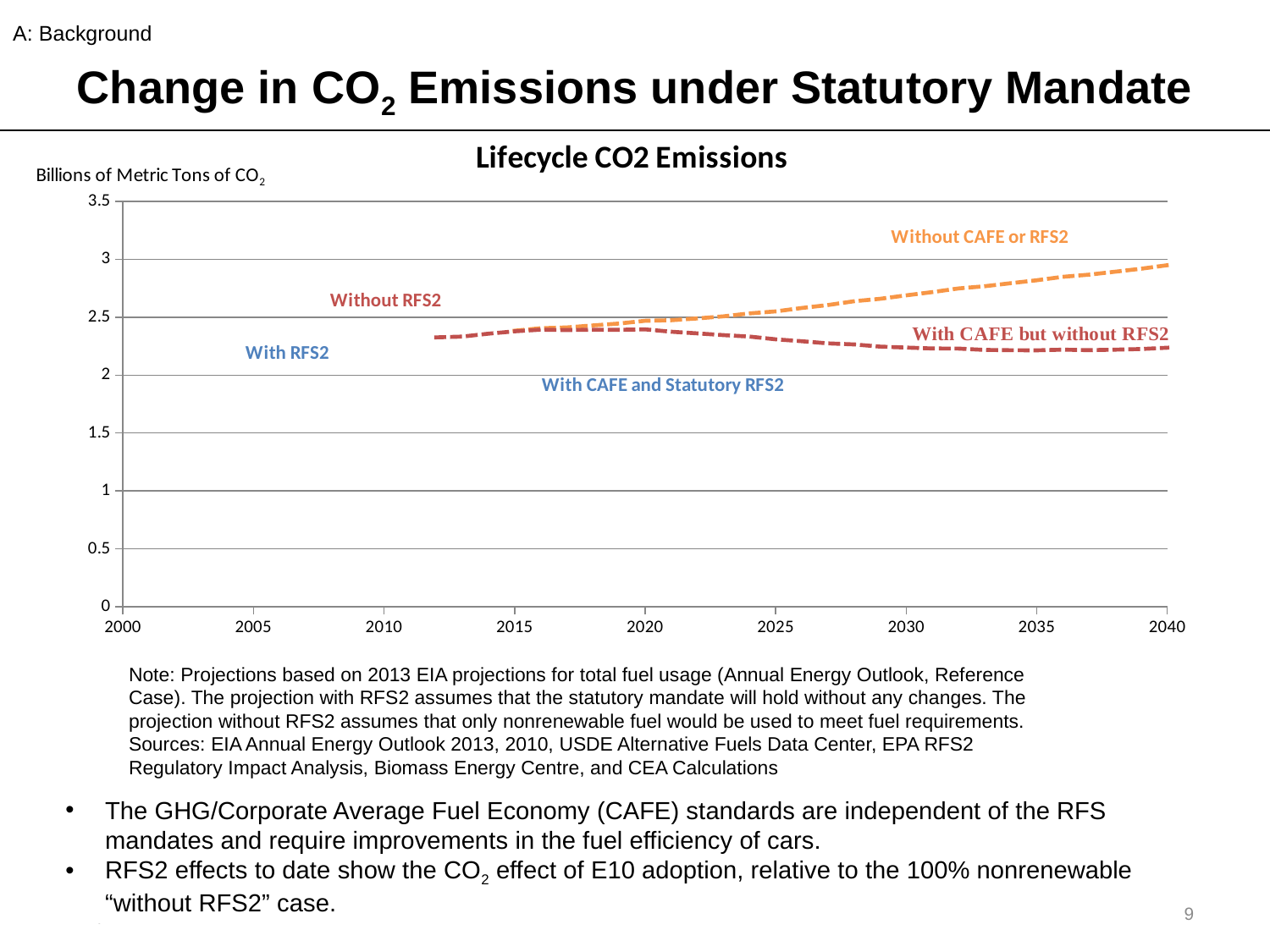
Is the value of the 'With CAFE but without RFS2' line in 2040 greater or less than 2? greater What is the last year shown on the horizontal axis of the chart? 2040 What is the highest value shown on the vertical axis of the chart? 3.5 Does the 'With CAFE but without RFS2' line rise or fall between 2020 and 2040? fall What is the title of the chart? Lifecycle CO2 Emissions Is the value of the 'Without CAFE or RFS2' line in 2040 greater or less than 3? less Is the value of the 'Without CAFE or RFS2' line in 2040 greater or less than 2.5? greater What kind of chart is shown on the slide? line chart What unit is given for the vertical axis of the chart? Billions of Metric Tons of CO2 Does the 'Without CAFE or RFS2' line rise or fall between 2020 and 2040? rise In 2040, which line is higher: 'Without CAFE or RFS2' or 'With CAFE but without RFS2'? Without CAFE or RFS2